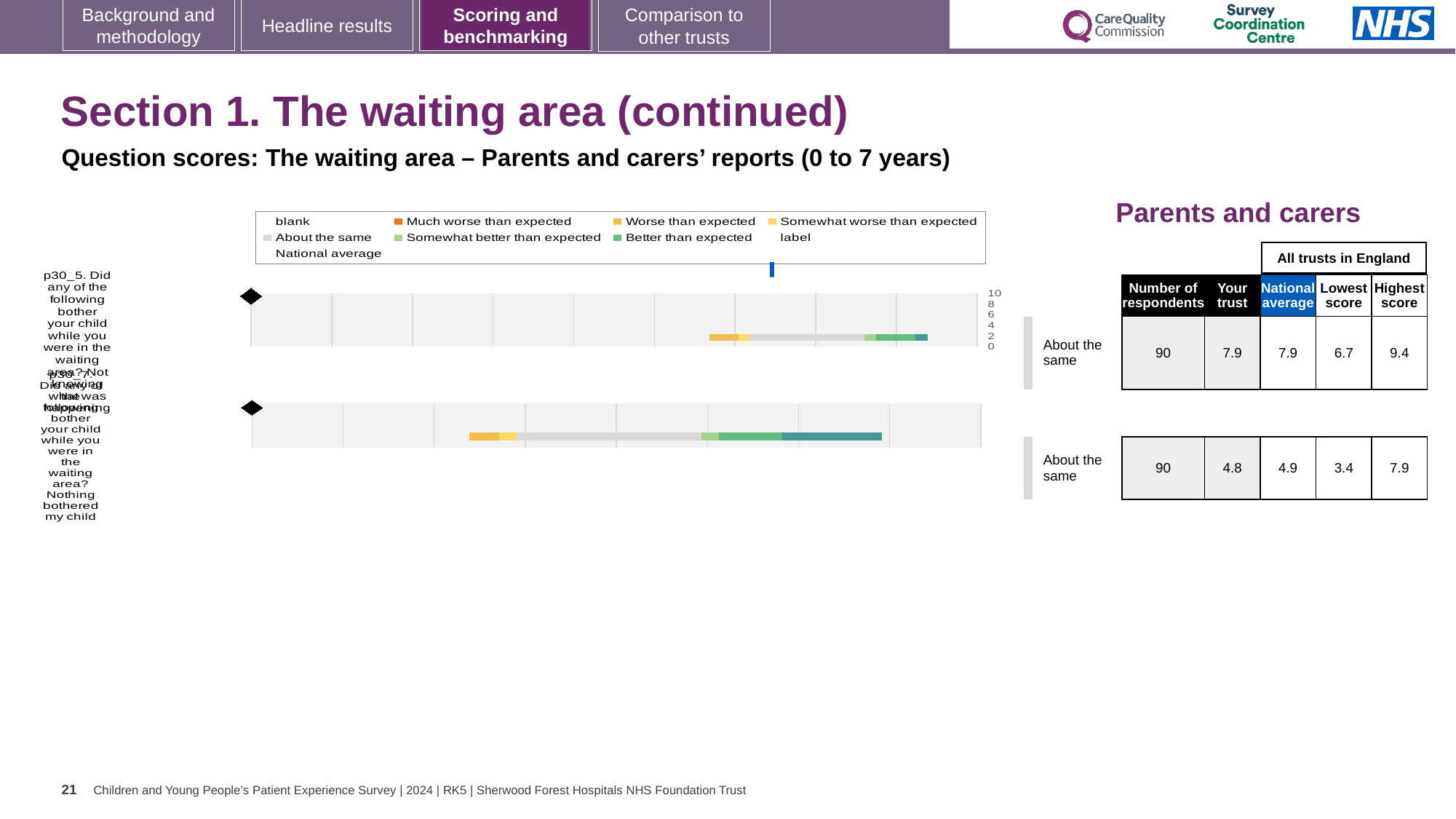
What kind of chart is used on this slide to show the question scores? bar chart For the top chart (p30_5), what is the difference between the highest score and the lowest score among all trusts in England? 2.7 For the top chart (p30_5, Not knowing what was happening), what is the lowest score among all trusts in England? 6.7 For the bottom chart (p30_7), what is the difference between the highest score and the lowest score among all trusts in England? 4.5 How many respondents are reported for the top chart (p30_5)? 90 Which question has the higher 'Your trust' score: p30_5 (Not knowing what was happening) or p30_7 (Nothing bothered my child)? p30_5 (Not knowing what was happening) For the bottom chart (p30_7, Nothing bothered my child), what is the highest score among all trusts in England? 7.9 For the bottom chart (p30_7, Nothing bothered my child), what is the national average score? 4.9 What benchmark category is shown next to both charts? About the same For the top chart (p30_5, Not knowing what was happening), what is the 'Your trust' score shown in the table? 7.9 For the bottom chart (p30_7, Nothing bothered my child), what is the 'Your trust' score shown in the table? 4.8 How many question charts are shown on the slide? 2